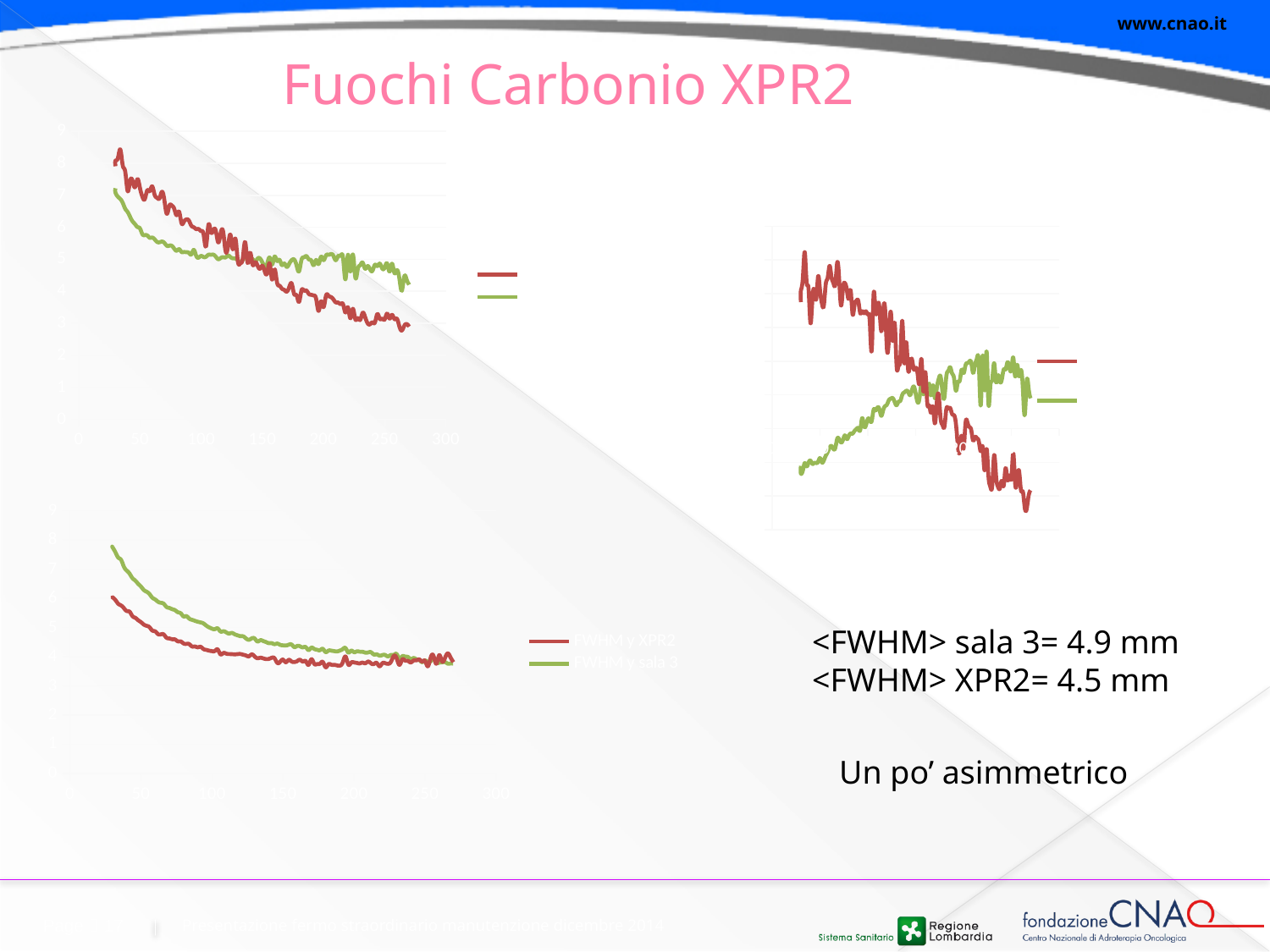
In the chart on the right, does the red line rise or fall as the x axis increases? fall What kind of chart is the chart on the right side of the slide? line chart In the bottom-left chart, which series is drawn in red according to the legend? FWHM y XPR2 In the bottom-left chart, which series is drawn in green according to the legend? FWHM y sala 3 How many charts are shown on the slide? 3 What kind of chart is the top-left chart on the slide? line chart In the bottom-left chart, does the FWHM y sala 3 line rise or fall as the x axis increases? fall In the bottom-left chart, is the value of the FWHM y XPR2 line at x = 250 greater or less than 5? less In the chart on the right, does the green line rise or fall as the x axis increases? rise How many series does the legend of the bottom-left chart list? 2 In the top-left chart, is the value of the red line at x = 50 greater or less than 5? greater